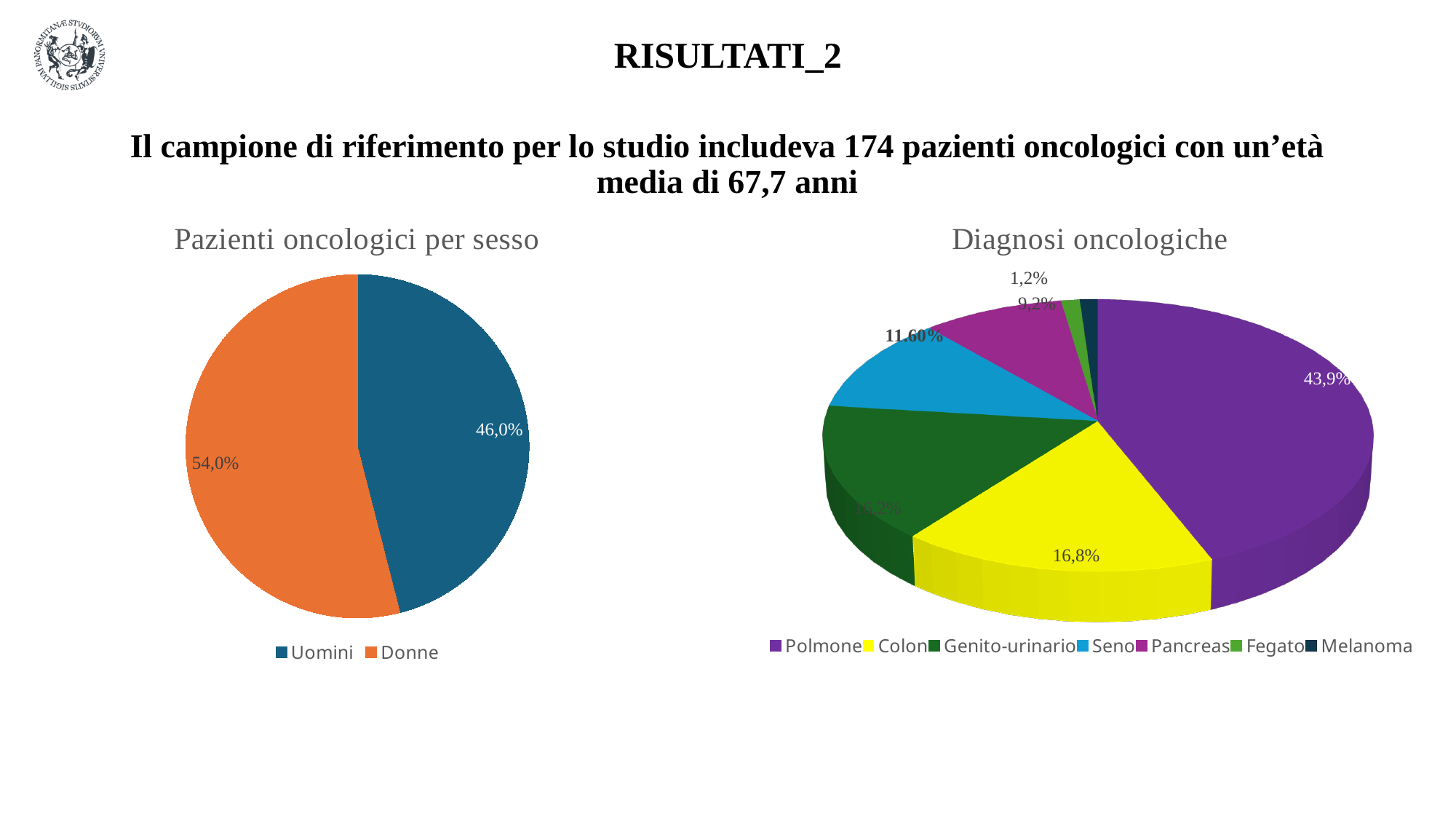
In the 'Pazienti oncologici per sesso' chart, what is the share for Uomini? 46,0% In the 'Pazienti oncologici per sesso' chart, which group has the larger share, Uomini or Donne? Donne In the 'Diagnosi oncologiche' chart, what is the share for Seno? 11,60% In the 'Pazienti oncologici per sesso' chart, what is the difference between the Donne and Uomini shares? 8,0% How many categories does the legend of the 'Diagnosi oncologiche' chart list? 7 In the 'Pazienti oncologici per sesso' chart, what is the share for Donne? 54,0% What kind of chart is the 'Pazienti oncologici per sesso' chart? pie chart How many entries does the legend of the 'Pazienti oncologici per sesso' chart list? 2 In the 'Diagnosi oncologiche' chart, what is the difference between the Polmone and Colon shares? 27,1% In the 'Diagnosi oncologiche' chart, which diagnosis has the largest share? Polmone In the 'Diagnosi oncologiche' chart, what is the share for Colon? 16,8% In the 'Diagnosi oncologiche' chart, what is the share for Polmone? 43,9%